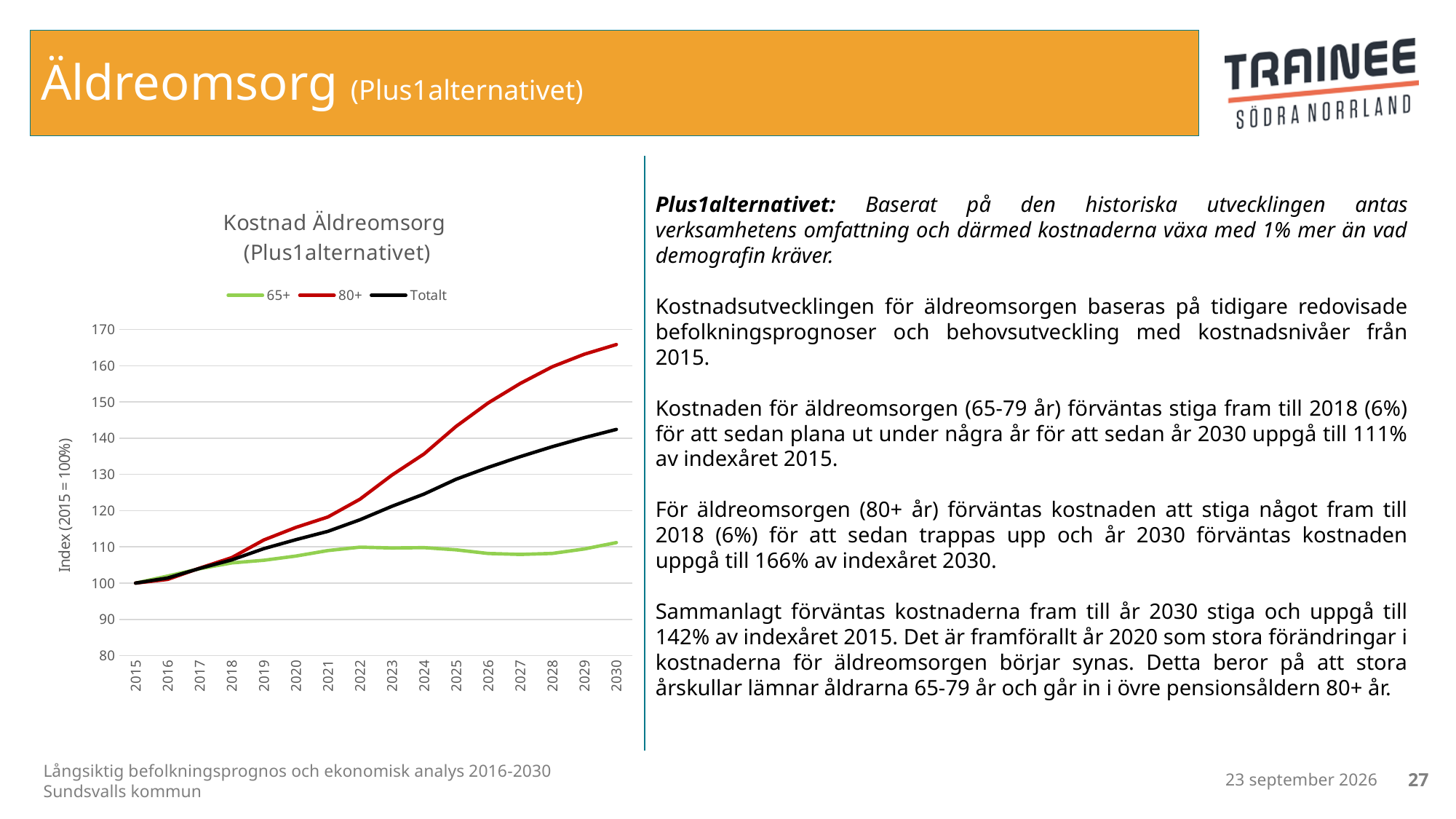
What is the label on the y axis of the chart? Index (2015 = 100%) What is the index value for all three series in 2015? 100 Is the value for 65+ in 2030 greater or less than 120? less Which series has the lowest value in 2030? 65+ Does the 80+ series rise or fall from 2015 to 2030? rise Is the value for Totalt in 2030 greater or less than 130? greater What kind of chart is shown on the slide? line chart How many series does the legend of the chart list? 3 How many years are plotted along the x axis of the chart? 16 Which series has the highest value in 2030? 80+ Which is larger in 2025, the value for 80+ or the value for 65+? 80+ Is the value for 80+ in 2030 greater or less than 160? greater